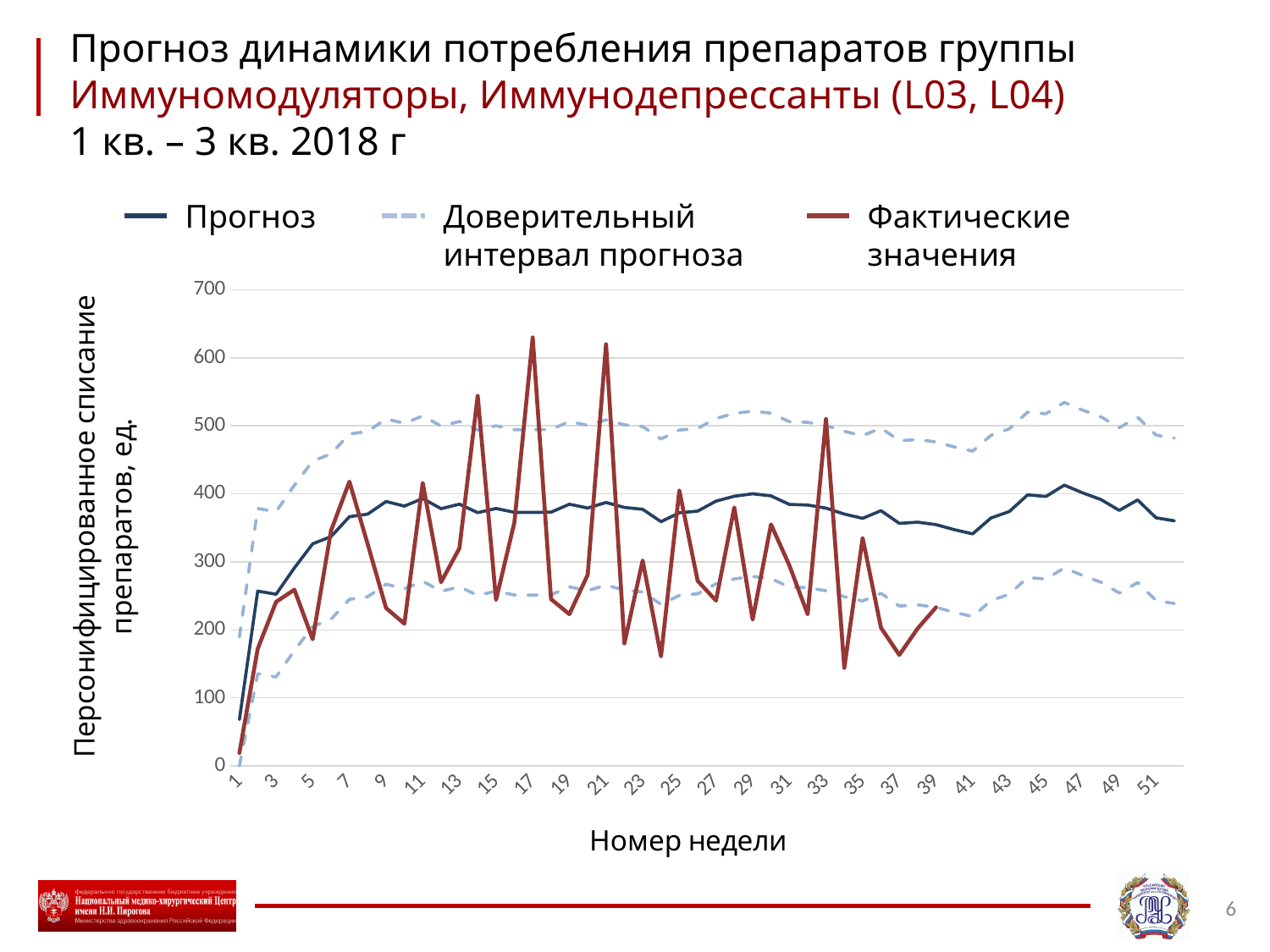
Is the value of Фактические значения at week 17 greater or less than 600? greater What kind of chart is shown on the slide? line chart Is the value of Прогноз at week 29 greater or less than 300? greater What is the title of the x axis? Номер недели At which week is the value of Фактические значения lowest? 1 Does the Прогноз line rise or fall from week 1 to week 9? rise Is the value of Прогноз at week 1 greater or less than 100? less How many series does the legend list? 3 At week 17, which is larger: Прогноз or Фактические значения? Фактические значения Which legend entry is drawn as a dashed light-blue line? Доверительный интервал прогноза